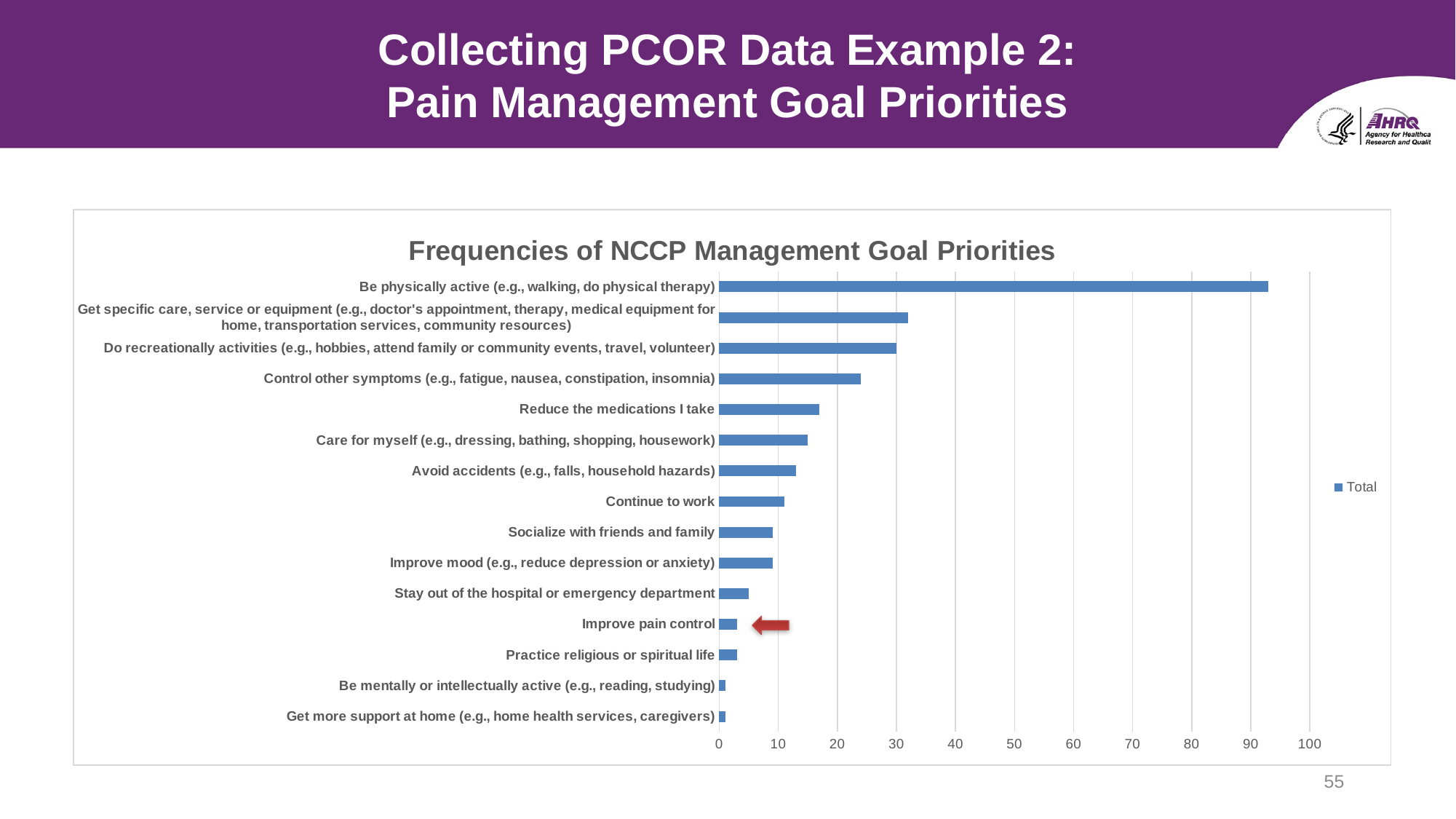
What is the title of the chart? Frequencies of NCCP Management Goal Priorities What kind of chart is shown on the slide? bar chart Is the value for 'Improve pain control' greater or less than 10? less Is the value for 'Control other symptoms (e.g., fatigue, nausea, constipation, insomnia)' greater or less than 20? greater Which has a larger value: 'Care for myself (e.g., dressing, bathing, shopping, housework)' or 'Practice religious or spiritual life'? Care for myself (e.g., dressing, bathing, shopping, housework) How many categories (goal priorities) are plotted in the chart? 15 Which has a larger value: 'Continue to work' or 'Stay out of the hospital or emergency department'? Continue to work Is the value for 'Reduce the medications I take' greater or less than 10? greater Which goal priority has the highest frequency? Be physically active (e.g., walking, do physical therapy) How many series does the legend list? 1